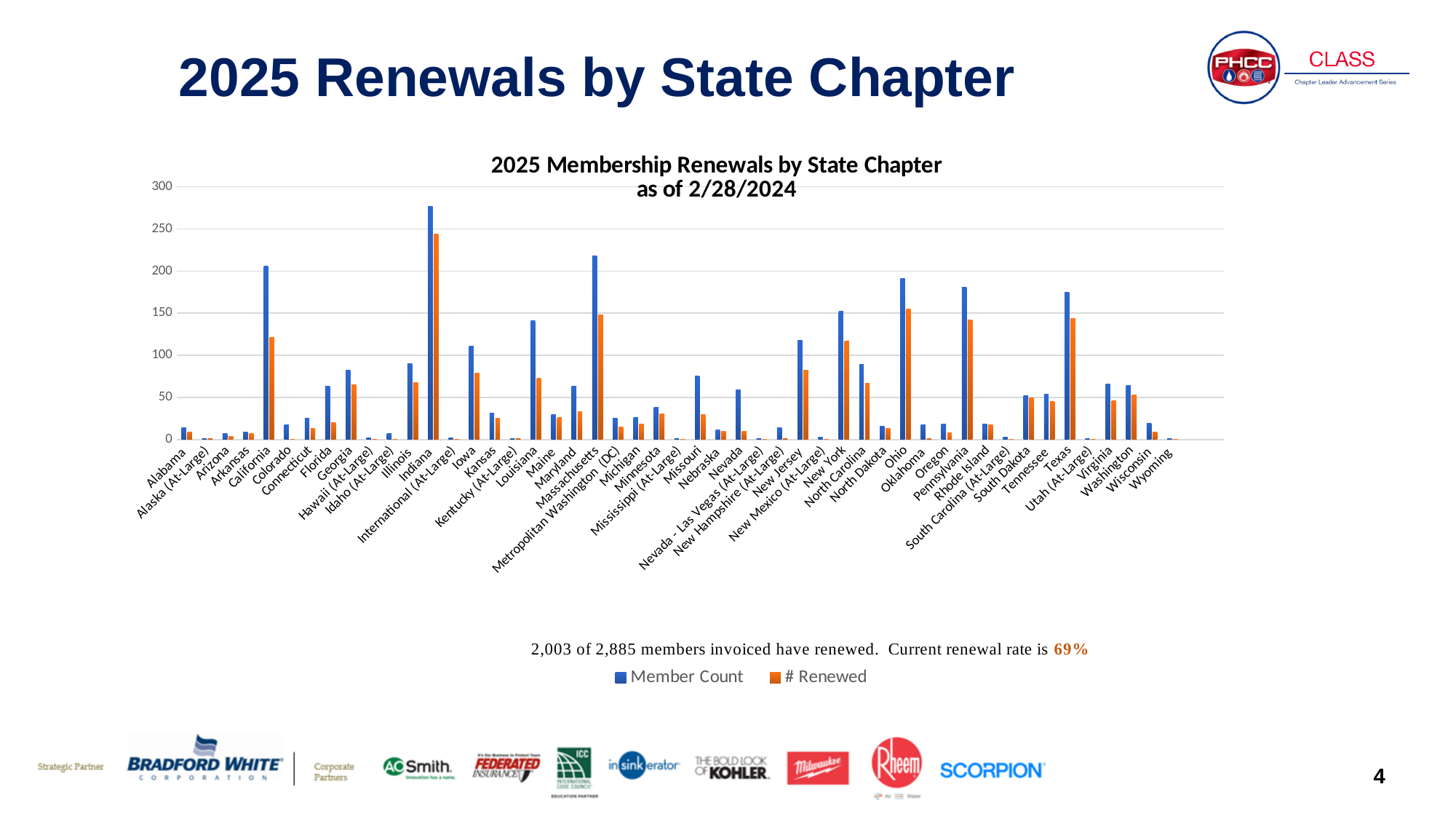
Which has the larger Member Count, Massachusetts or Ohio? Massachusetts How many state chapters are shown on the x axis of the chart? 49 Is the Member Count for California greater or less than 200? greater Which has the larger # Renewed, Ohio or California? Ohio What kind of chart is shown on the slide? Bar chart Is the Member Count for Texas greater or less than 150? greater What is the title of the chart? 2025 Membership Renewals by State Chapter as of 2/28/2024 How many series does the chart legend list? 2 Is the # Renewed for Indiana greater or less than 200? greater Which state chapter has the highest Member Count? Indiana Which state chapter has the highest # Renewed? Indiana